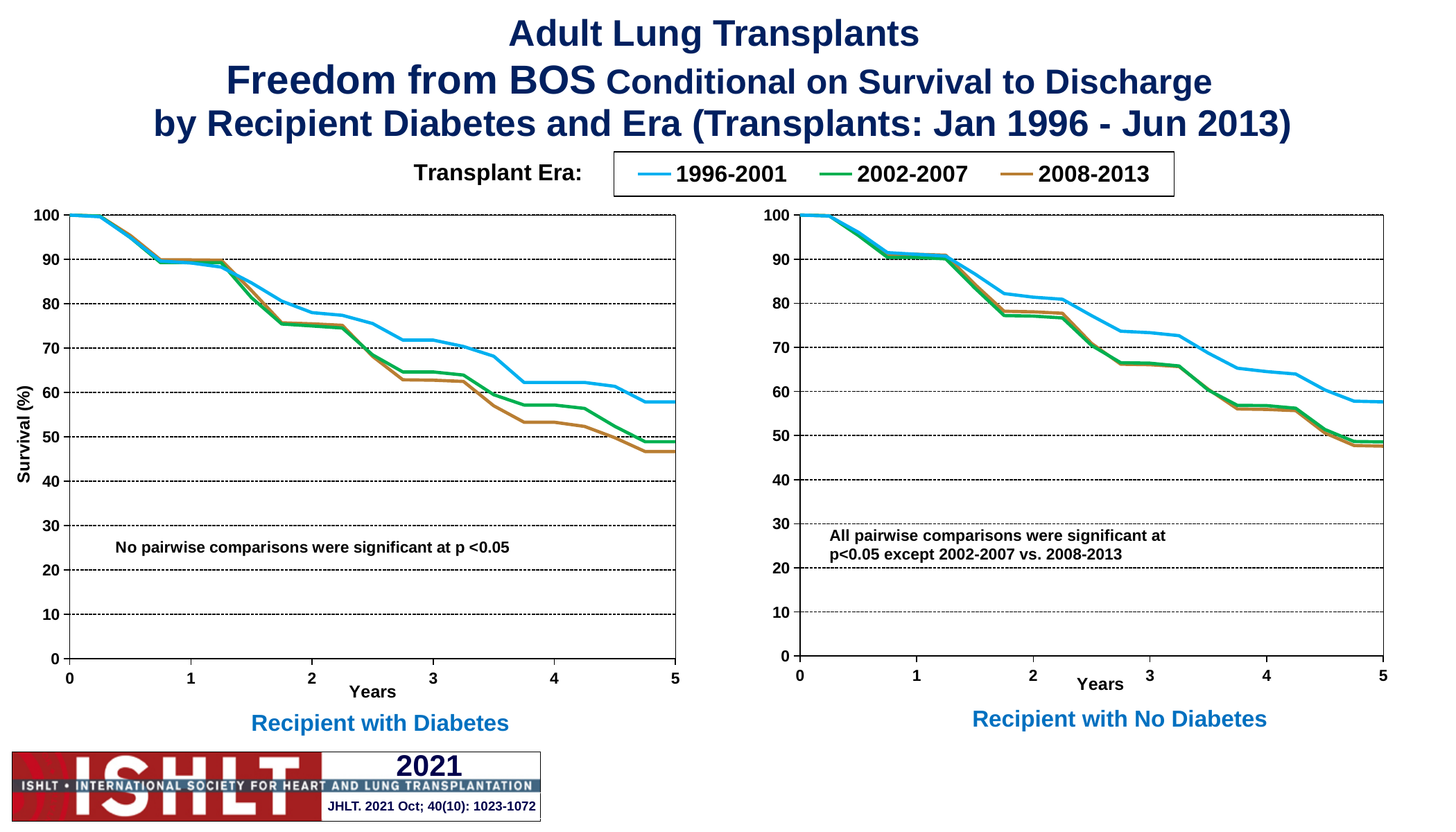
In the 'Recipient with No Diabetes' chart, which era has the higher value at 4 years: 1996-2001 or 2002-2007? 1996-2001 In the 'Recipient with Diabetes' chart, is the value for 1996-2001 at 5 years greater or less than 50? greater In the 'Recipient with Diabetes' chart, which era has the higher value at 4 years: 1996-2001 or 2008-2013? 1996-2001 In the 'Recipient with No Diabetes' chart, is the value for 1996-2001 at 5 years greater or less than 50? greater In the 'Recipient with No Diabetes' chart, does the 1996-2001 line rise or fall from year 0 to year 5? fall Which transplant era is shown in green in the legend? 2002-2007 In the 'Recipient with Diabetes' chart, do the survival values rise or fall as years increase? fall What is the label of the y axis on the left chart? Survival (%) In the 'Recipient with No Diabetes' chart, is the value for 2002-2007 at 3 years greater or less than 70? less What kind of chart is the 'Recipient with Diabetes' chart on the left? line chart How many transplant eras does the legend list? 3